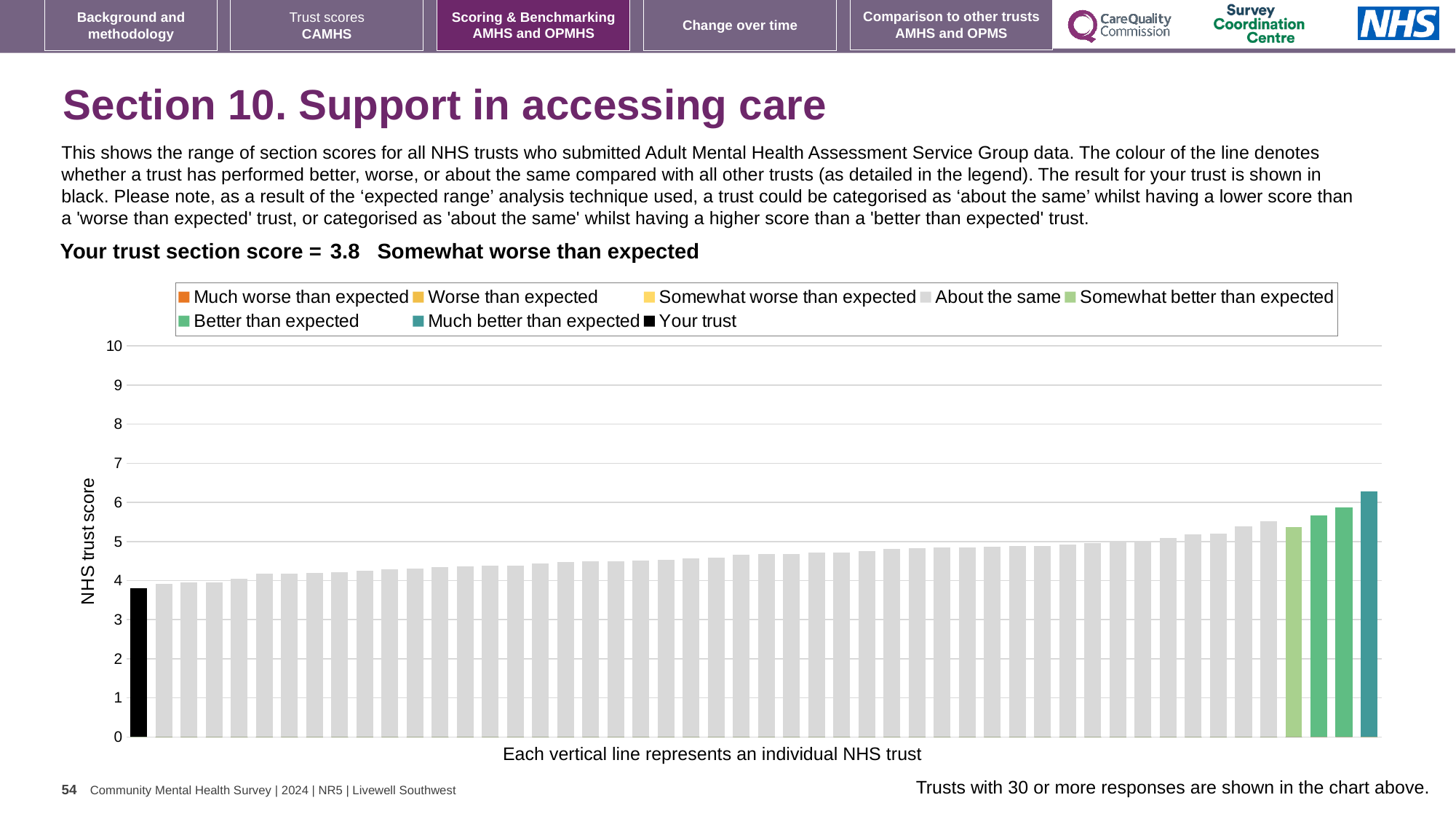
Which legend category does the tallest bar belong to? Much better than expected What is the label on the y axis of the chart? NHS trust score Is the value of the tallest bar greater or less than 7? less What is the section score for your trust? 3.8 Do the bar values rise or fall from left to right along the x axis? rise Is the value of the tallest bar greater or less than 6? greater Which bar is the lowest in the chart? Your trust What colour is the bar for your trust? black Is the value for your trust greater or less than 4? less What kind of chart is shown on the slide? bar chart How many bars are coloured as 'Much better than expected'? 1 How many entries does the chart legend list? 8